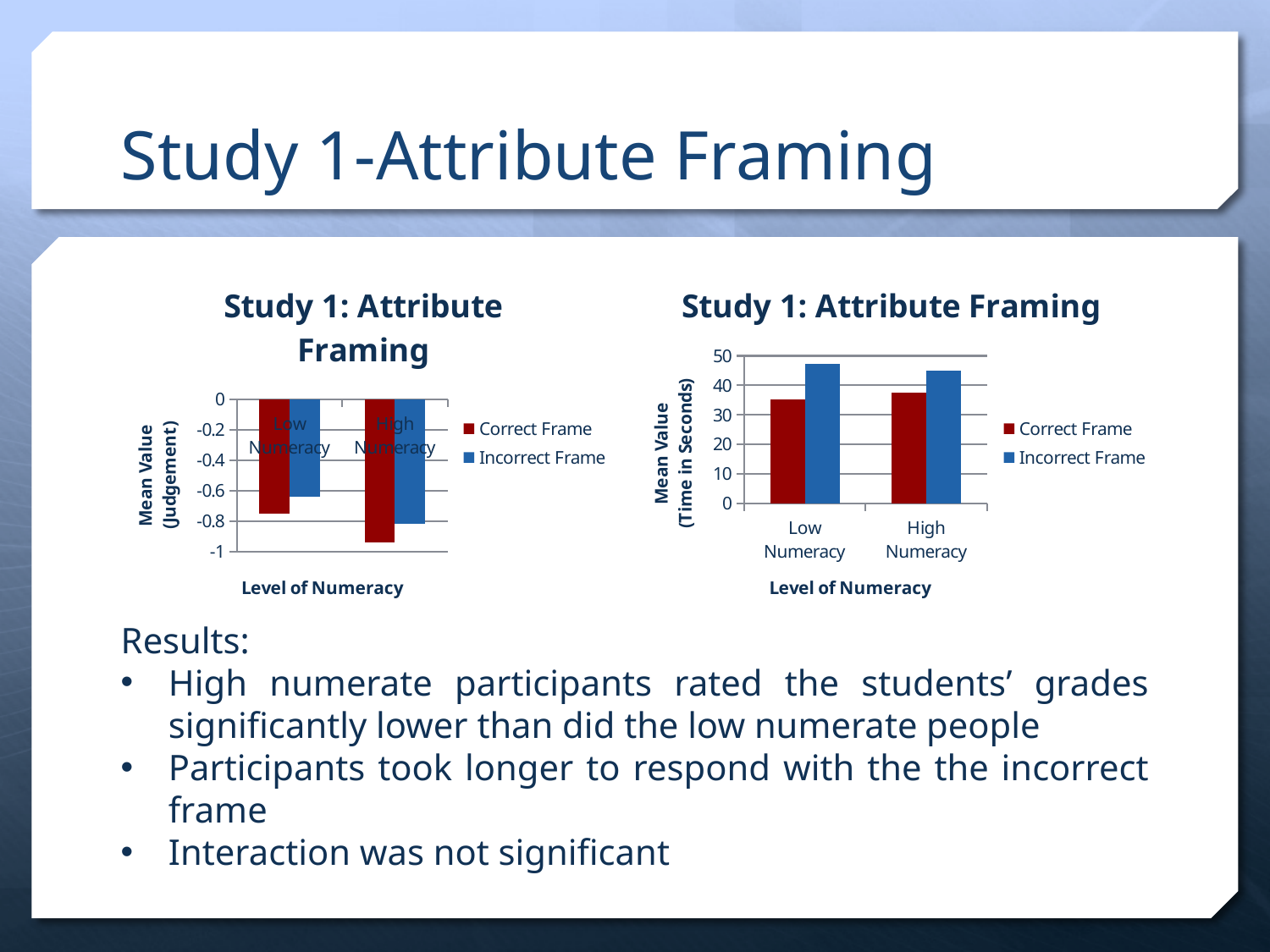
In the left chart, is the value for Incorrect Frame at Low Numeracy greater or less than -0.8? greater In the left chart, is the value for Correct Frame at High Numeracy greater or less than -0.8? less How many categories are shown on the x axis of the left chart? 2 What is the y-axis title of the right chart? Mean Value (Time in Seconds) How many series does the legend of the right chart list? 2 What is the x-axis title of the left chart? Level of Numeracy What kind of chart is the left chart on the slide? bar chart In the right chart, is the value for Incorrect Frame at High Numeracy greater or less than 40? greater In the right chart, which series has the larger value at Low Numeracy, Correct Frame or Incorrect Frame? Incorrect Frame What kind of chart is the right chart on the slide? bar chart